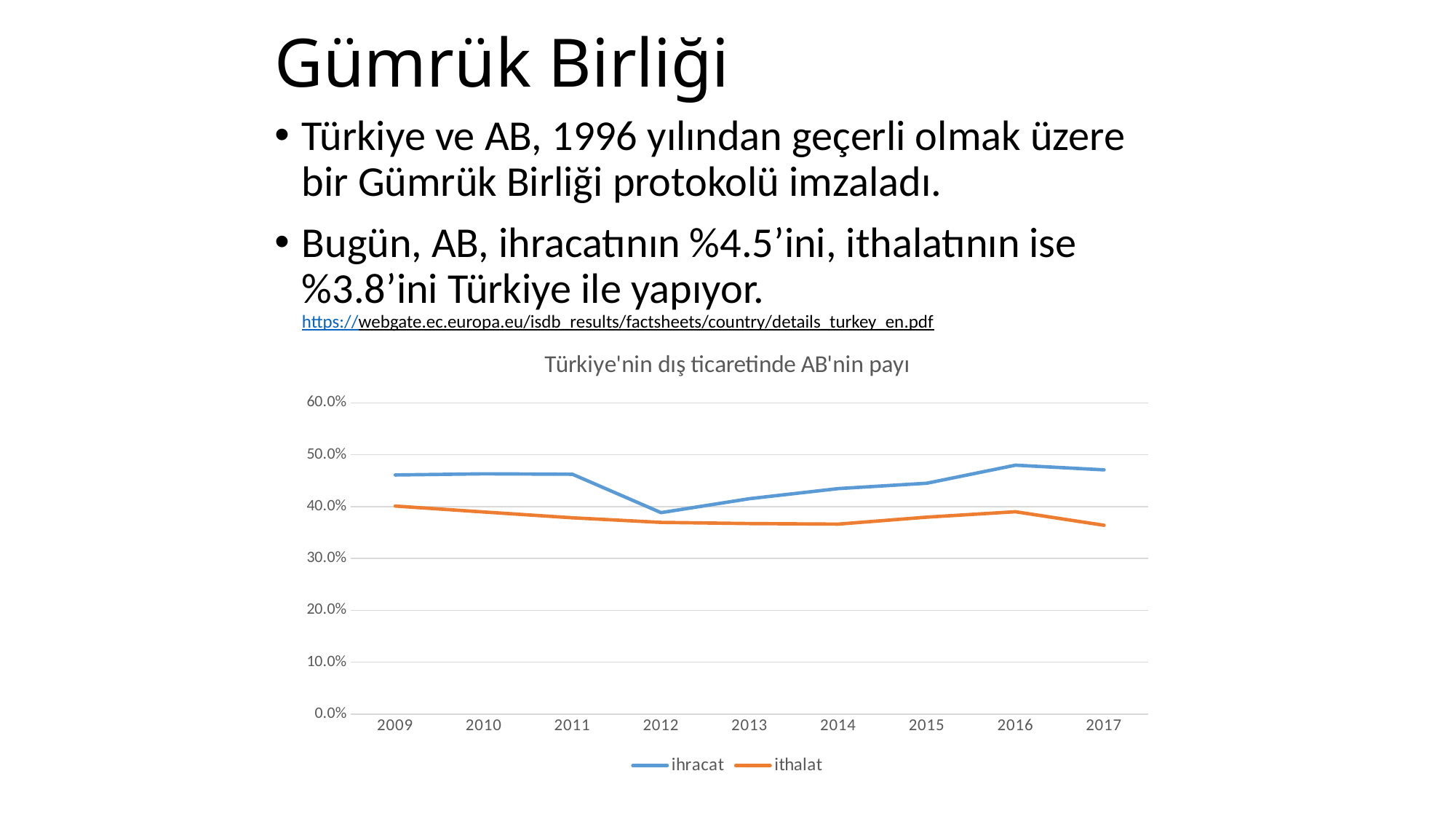
In which year is the ithalat series at its highest? 2009 How many series does the legend list? 2 What kind of chart is shown on the slide? line chart How many years are plotted on the x axis? 9 Which series is drawn in orange? ithalat Is the ihracat value for 2012 greater or less than 40.0%? less Is the ihracat value for 2016 greater or less than 50.0%? less Does the ithalat series rise or fall from 2009 to 2012? fall In which year is the ihracat series at its lowest? 2012 What is the title of the chart? Türkiye'nin dış ticaretinde AB'nin payı Which series has the larger value in 2016, ihracat or ithalat? ihracat In which year is the ihracat series at its highest? 2016